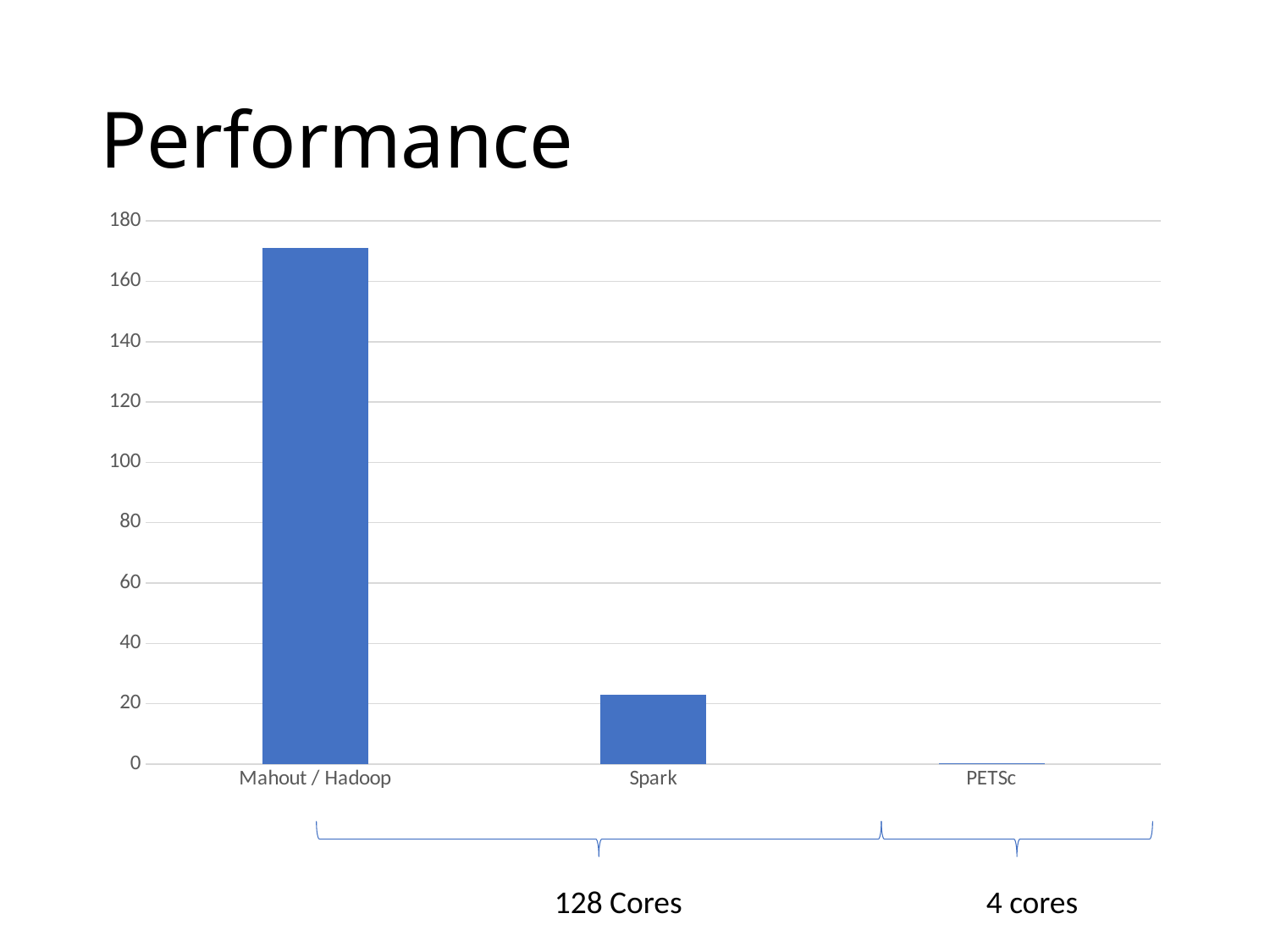
What is the title of the slide containing the chart? Performance Do the values rise or fall moving from left to right along the x axis? fall Which is larger, the value for Spark or the value for PETSc? Spark Is the value for PETSc greater or less than 20? less Which is larger, the value for Mahout / Hadoop or the value for Spark? Mahout / Hadoop How many categories are plotted on the chart? 3 According to the bracket annotation below the chart, how many cores were used for PETSc? 4 cores What kind of chart is shown on the slide? bar chart Is the value for Spark greater or less than 40? less Is the value for Mahout / Hadoop greater or less than 160? greater Which category has the lowest value? PETSc Which category has the highest value? Mahout / Hadoop